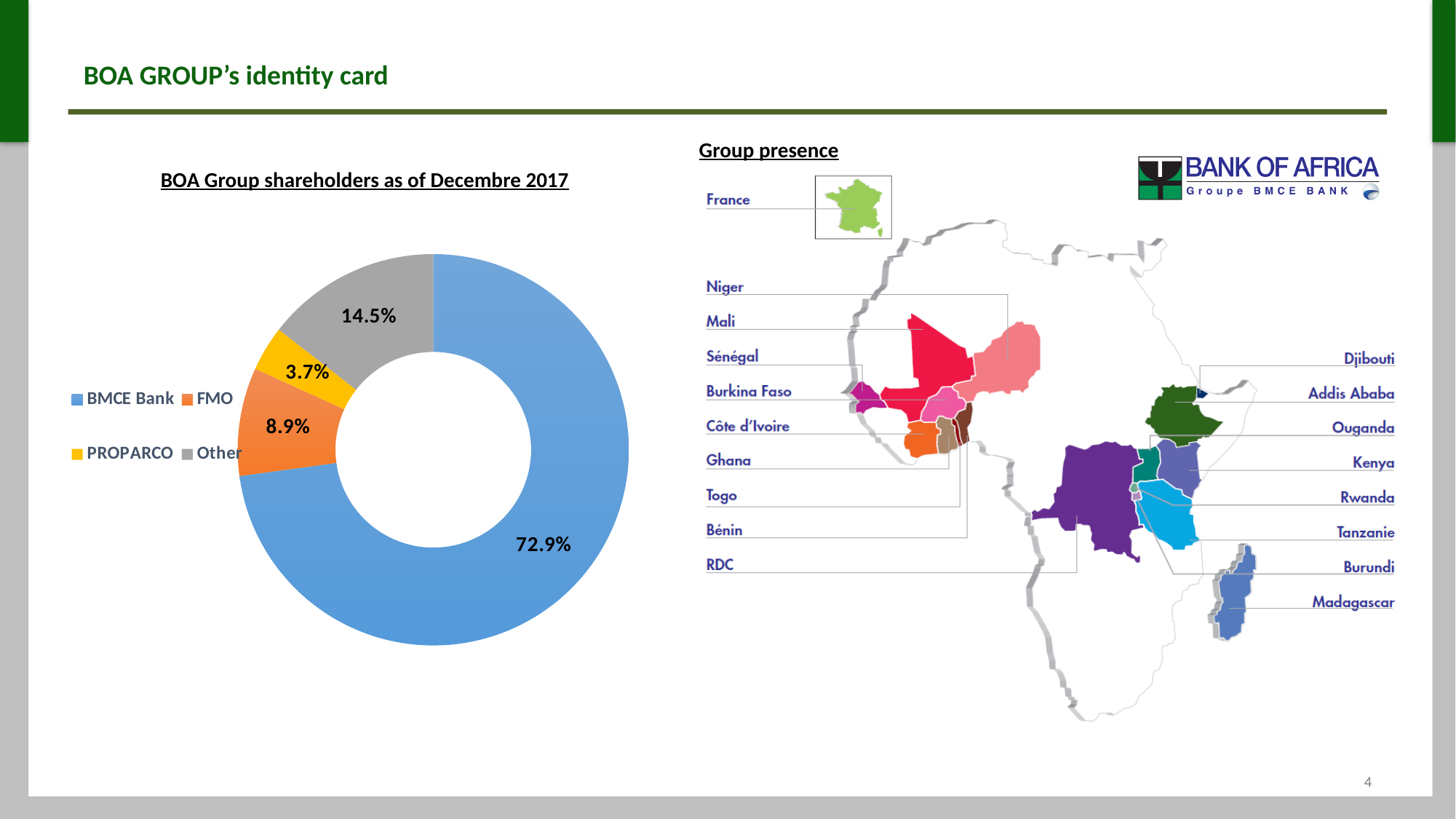
How many shareholder categories are shown in the BOA Group shareholders chart? 4 What kind of chart is used to show BOA Group shareholders? Pie chart (donut) What share of BOA Group shareholders does PROPARCO hold? 3.7% What colour represents BMCE Bank in the shareholders chart? Blue What share of BOA Group shareholders does BMCE Bank hold? 72.9% What is the difference between the Other share and the FMO share? 5.6% What is the title of the chart on the left of the slide? BOA Group shareholders as of Decembre 2017 Which shareholder holds the smallest share in the BOA Group shareholders chart? PROPARCO Which shareholder holds the largest share in the BOA Group shareholders chart? BMCE Bank What share of BOA Group shareholders is labelled Other? 14.5% Which holds a larger share, FMO or PROPARCO? FMO What share of BOA Group shareholders does FMO hold? 8.9%